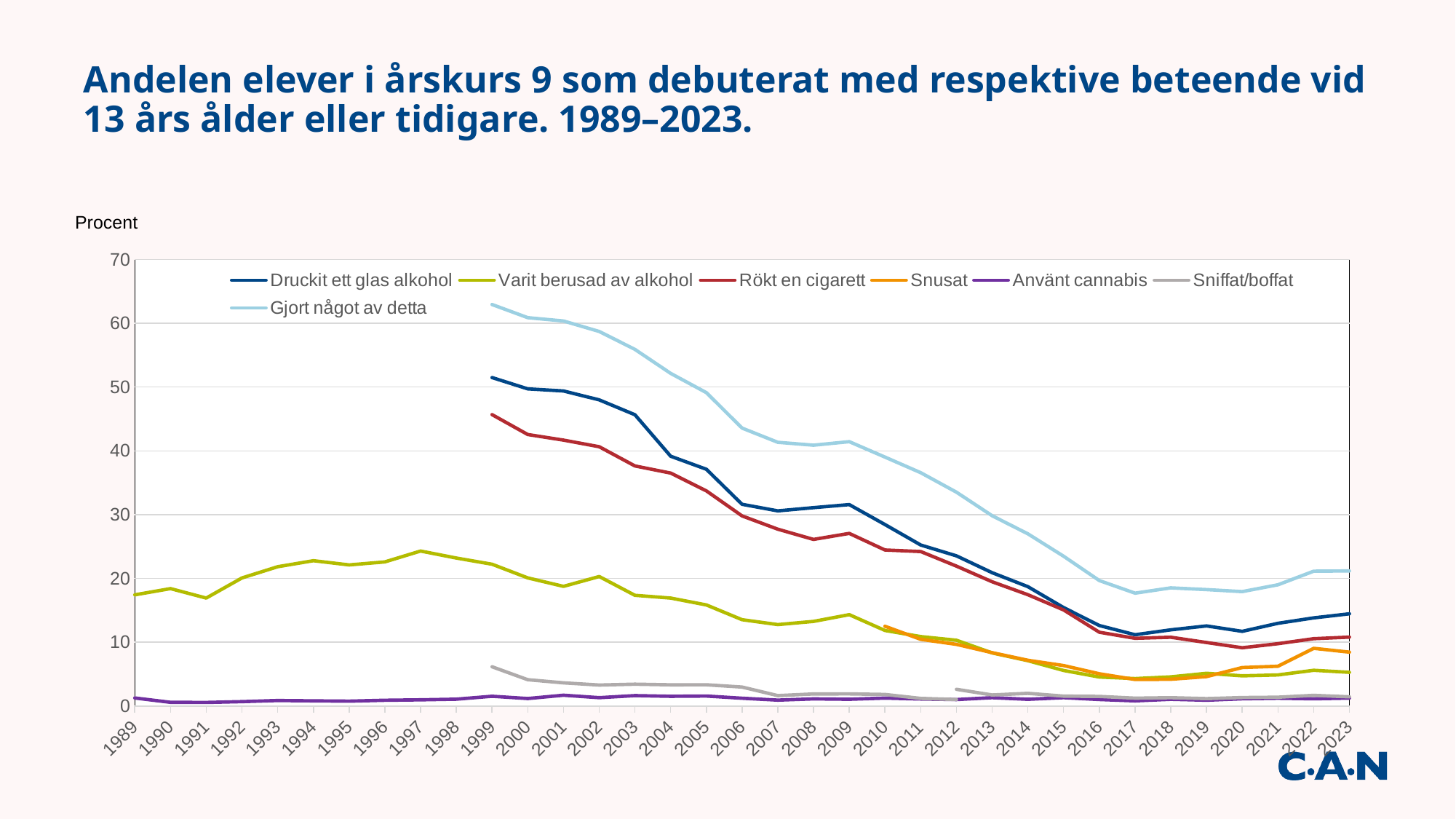
In 2023, which is larger: Druckit ett glas alkohol or Rökt en cigarett? Druckit ett glas alkohol Is the value for Druckit ett glas alkohol in 1999 greater or less than 50? greater What is the label on the y axis? Procent Is the value for Gjort något av detta in 2017 greater or less than 20? less Is the value for Gjort något av detta in 1999 greater or less than 60? greater How many series does the legend list? 7 How many years are labelled on the x axis? 35 What kind of chart is shown on the slide? Line chart Does the Gjort något av detta series rise or fall from 1999 to 2017? Fall Which series has the lowest value in 1999? Använt cannabis Which series has the highest value in 1999? Gjort något av detta